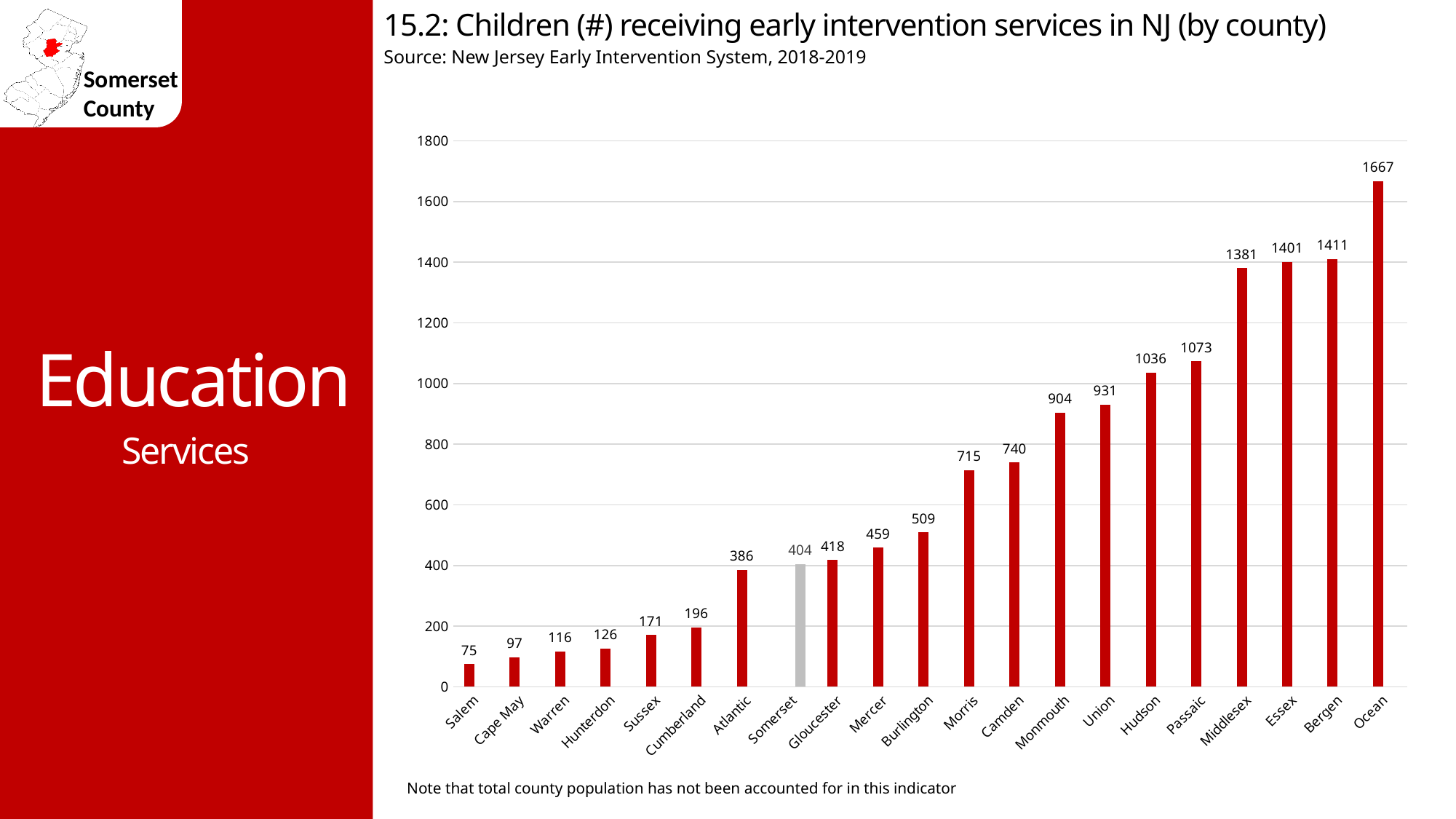
What kind of chart is shown on the slide? Bar chart What is the value shown for Ocean County? 1667 How many children received early intervention services in Somerset County? 404 What is the difference between the values for Bergen and Essex? 10 Is the value for Passaic greater or less than 1000? greater Which county has the lowest number of children receiving early intervention services? Salem Which county has a larger value, Morris or Camden? Camden What is the difference between the values for Ocean and Salem? 1592 What is the value shown for Hudson County? 1036 Which county's bar is shown in grey rather than red? Somerset How many counties are shown on the chart? 21 Which county has the highest number of children receiving early intervention services? Ocean